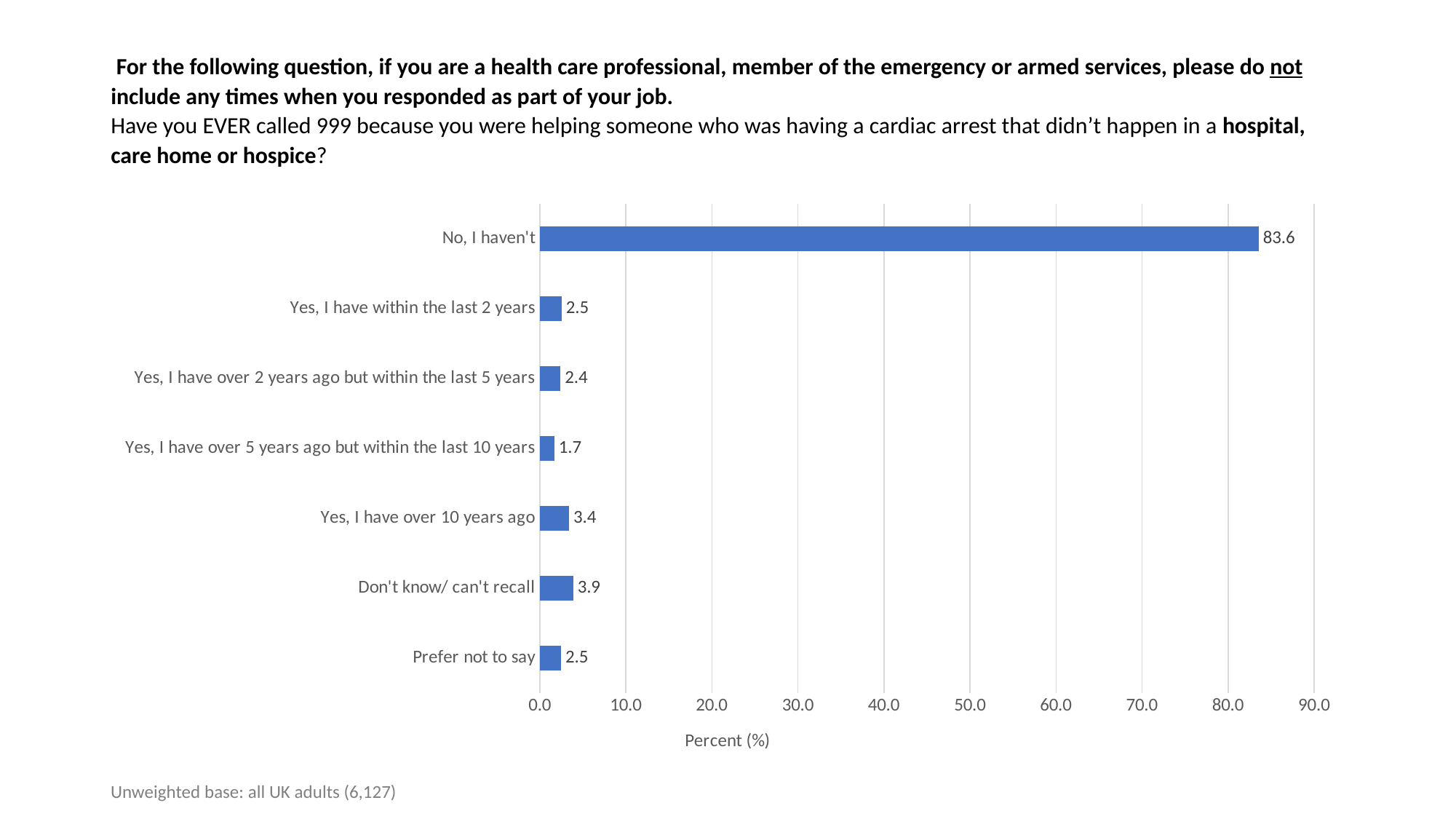
What is the value for "No, I haven't"? 83.6 What is the value for "Yes, I have over 5 years ago but within the last 10 years"? 1.7 What is the value for "Don't know/ can't recall"? 3.9 What kind of chart is shown on the slide? bar chart Which is larger: "Yes, I have over 10 years ago" or "Yes, I have over 2 years ago but within the last 5 years"? Yes, I have over 10 years ago Which category has the lowest value? Yes, I have over 5 years ago but within the last 10 years What is the difference between "No, I haven't" and "Don't know/ can't recall"? 79.7 Is the value for "No, I haven't" greater or less than 80.0? greater How many categories are shown in the chart? 7 What is the value for "Yes, I have within the last 2 years"? 2.5 Which category has the highest value? No, I haven't What is the label of the horizontal axis? Percent (%)